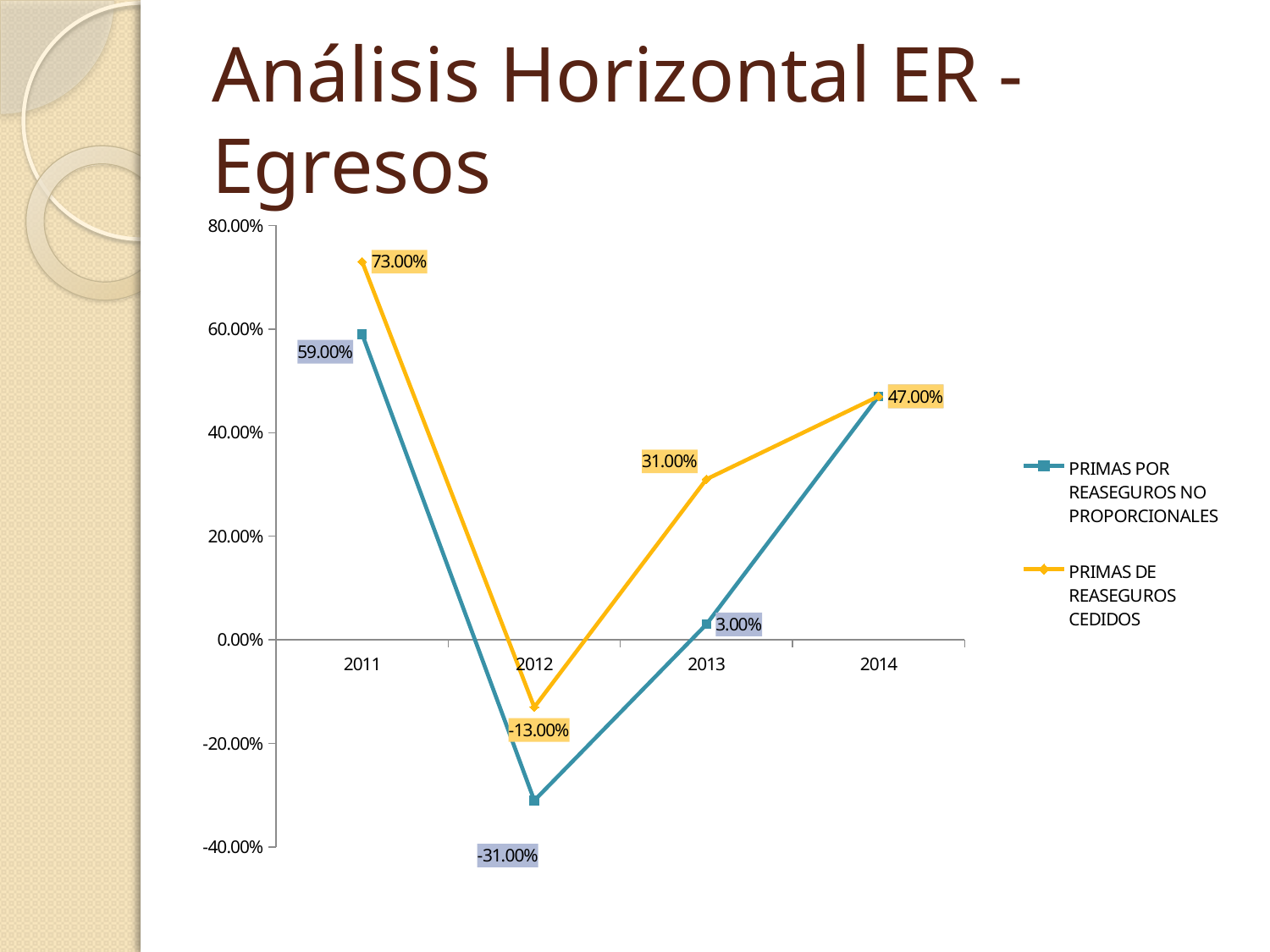
In which year is PRIMAS DE REASEGUROS CEDIDOS highest? 2011 In which year is PRIMAS POR REASEGUROS NO PROPORCIONALES lowest? 2012 How many series does the legend list? 2 Which series has the larger value in 2013, PRIMAS POR REASEGUROS NO PROPORCIONALES or PRIMAS DE REASEGUROS CEDIDOS? PRIMAS DE REASEGUROS CEDIDOS What type of chart is shown on the slide? line chart How many years are shown on the x axis? 4 What is the value for PRIMAS DE REASEGUROS CEDIDOS in 2014? 47.00% What is the value for PRIMAS DE REASEGUROS CEDIDOS in 2012? -13.00% What is the difference between PRIMAS DE REASEGUROS CEDIDOS and PRIMAS POR REASEGUROS NO PROPORCIONALES in 2011? 14.00% Does PRIMAS DE REASEGUROS CEDIDOS rise or fall from 2012 to 2014? rise What is the value for PRIMAS POR REASEGUROS NO PROPORCIONALES in 2011? 59.00% What is the value for PRIMAS POR REASEGUROS NO PROPORCIONALES in 2013? 3.00%